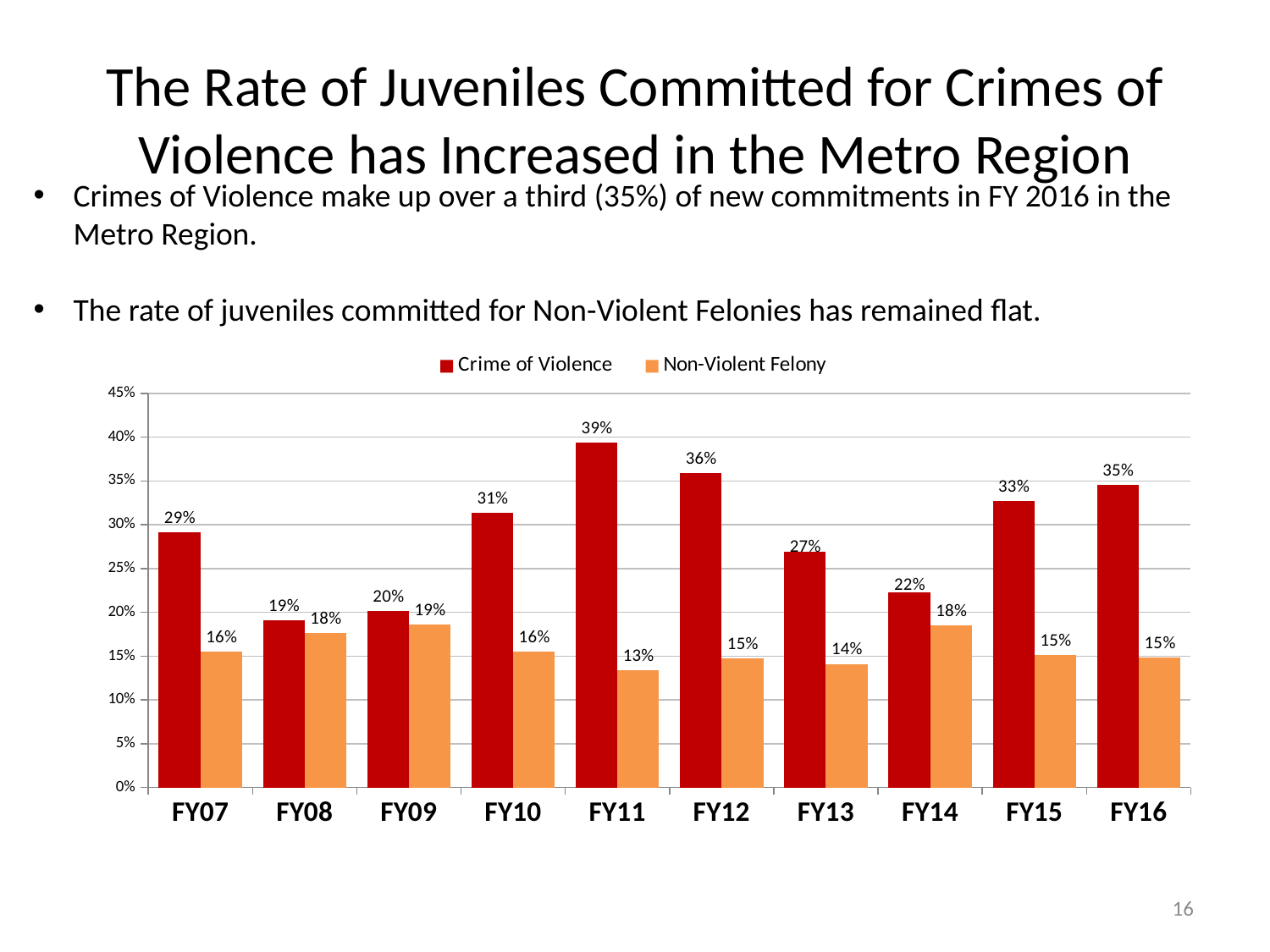
Which fiscal year has the lowest Non-Violent Felony value? FY11 What is the Crime of Violence value for FY11? 39% What is the Non-Violent Felony value for FY09? 19% Which fiscal year has the highest Crime of Violence value? FY11 What is the difference between the Crime of Violence and Non-Violent Felony values in FY12? 21% Is the Crime of Violence value for FY13 greater or less than 25%? greater How many series does the legend list? 2 What kind of chart is shown on the slide? Bar chart Which is larger in FY08: the Crime of Violence value or the Non-Violent Felony value? Crime of Violence What colour are the Non-Violent Felony bars? Orange How many fiscal years are shown on the x axis? 10 What is the Crime of Violence value for FY16? 35%